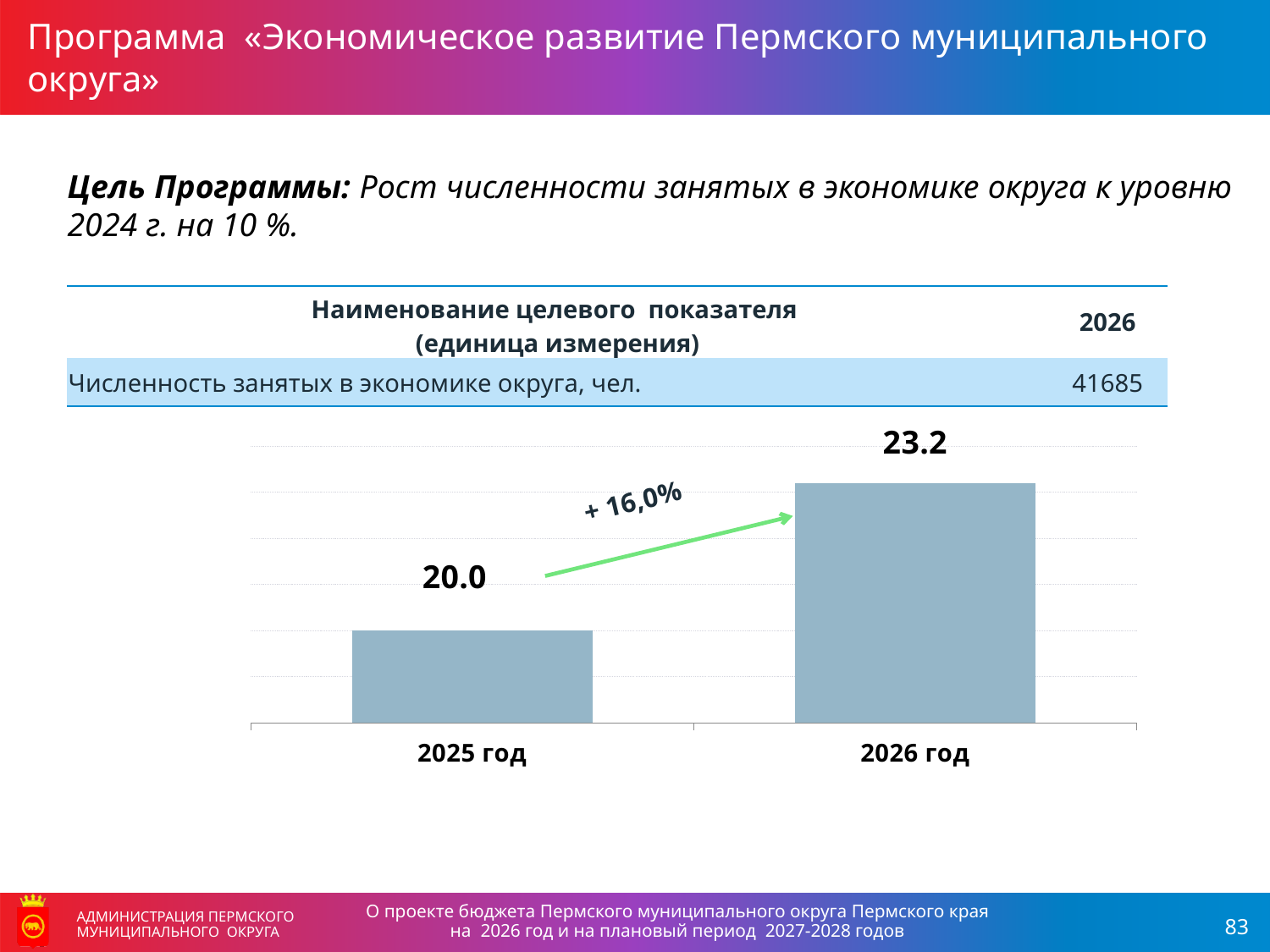
What colour are the bars in the chart? grey-blue Do the values rise or fall from 2025 год to 2026 год? rise What is the difference between the values for 2026 год and 2025 год? 3.2 What is the value for 2026 год? 23.2 What kind of chart is shown on the slide? bar chart Which year has the highest value? 2026 год What percentage change is written next to the arrow between the two bars? + 16,0% What is the value for 2025 год? 20.0 Which year has the lowest value? 2025 год How many bars are shown in the chart? 2 Which is larger, the value for 2025 год or the value for 2026 год? 2026 год